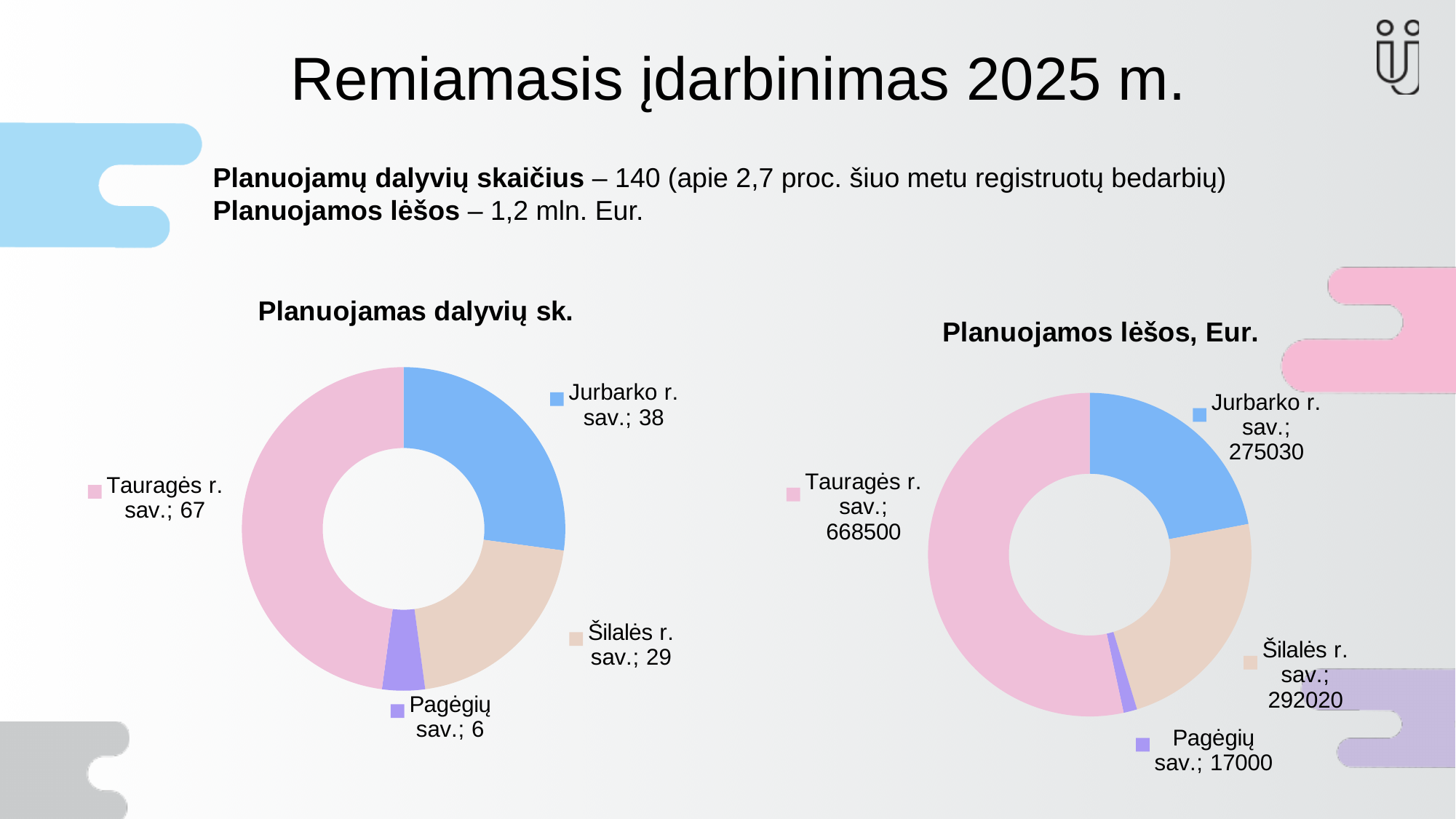
In the chart titled "Planuojamas dalyvių sk.", which category has the lowest value? Pagėgių sav. In the chart titled "Planuojamos lėšos, Eur.", what is the value for Šilalės r. sav.? 292020 In the chart titled "Planuojamas dalyvių sk.", how many categories are shown? 4 In the chart titled "Planuojamos lėšos, Eur.", what is the value for Pagėgių sav.? 17000 In the chart titled "Planuojamos lėšos, Eur.", which is larger, the value for Jurbarko r. sav. or Šilalės r. sav.? Šilalės r. sav. In the chart titled "Planuojamas dalyvių sk.", what is the difference between the values for Tauragės r. sav. and Šilalės r. sav.? 38 In the chart titled "Planuojamas dalyvių sk.", which category has the highest value? Tauragės r. sav. In the chart titled "Planuojamos lėšos, Eur.", which category has the highest value? Tauragės r. sav. In the chart titled "Planuojamas dalyvių sk.", what colour is the slice for Pagėgių sav.? Purple What kind of chart is the chart titled "Planuojamas dalyvių sk."? Doughnut chart In the chart titled "Planuojamas dalyvių sk.", what is the value for Jurbarko r. sav.? 38 In the chart titled "Planuojamos lėšos, Eur.", what is the difference between the values for Tauragės r. sav. and Jurbarko r. sav.? 393470